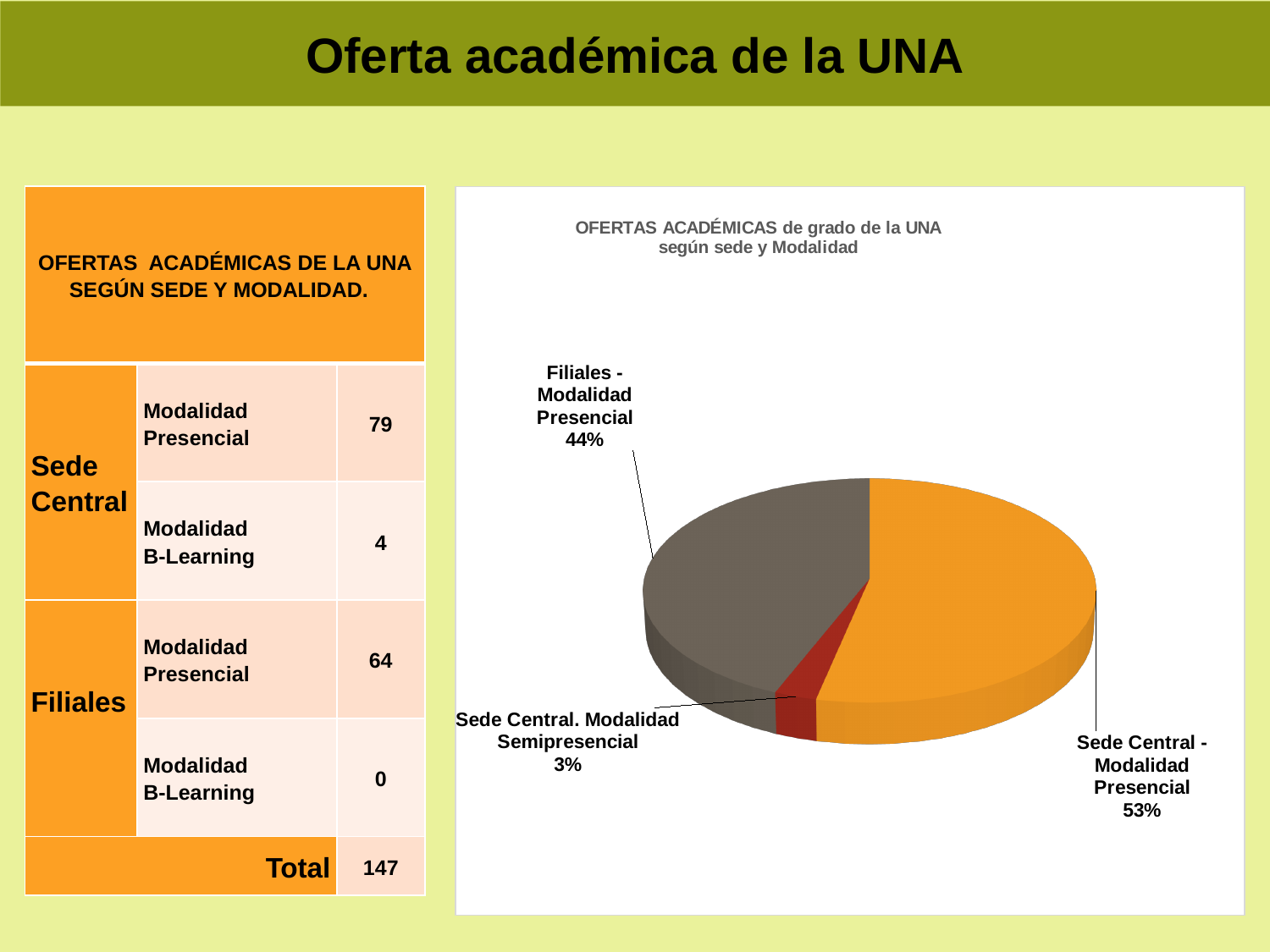
What share of the pie does Sede Central - Modalidad Presencial represent? 53% Which slice of the pie chart is the largest? Sede Central - Modalidad Presencial Which is larger in the pie chart: Filiales - Modalidad Presencial or Sede Central. Modalidad Semipresencial? Filiales - Modalidad Presencial What share of the pie does Sede Central. Modalidad Semipresencial represent? 3% What is the difference in percentage points between the Filiales - Modalidad Presencial slice and the Sede Central. Modalidad Semipresencial slice? 41 What colour is the Sede Central - Modalidad Presencial slice in the pie chart? orange Which slice of the pie chart is the smallest? Sede Central. Modalidad Semipresencial What is the title of the pie chart? OFERTAS ACADÉMICAS de grado de la UNA según sede y Modalidad How many slices does the pie chart have? 3 What kind of chart is shown on the slide? pie chart What is the difference in percentage points between the Sede Central - Modalidad Presencial slice and the Filiales - Modalidad Presencial slice? 9 What share of the pie does Filiales - Modalidad Presencial represent? 44%